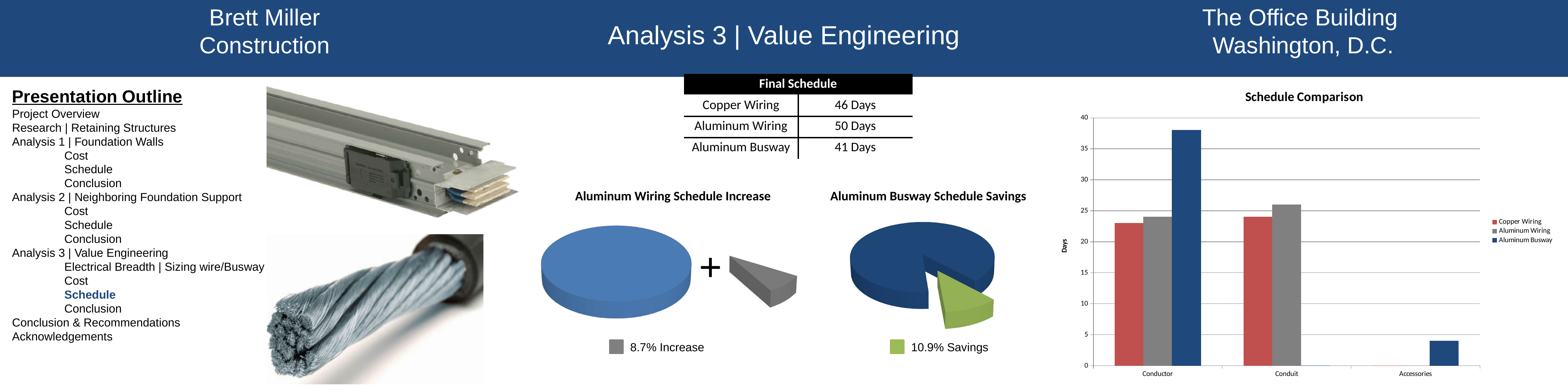
In the Aluminum Busway Schedule Savings pie chart, what share does the green slice represent? 10.9% Savings In the Schedule Comparison chart, how many categories are shown on the x axis? 3 In the Schedule Comparison chart, which category has the tallest Aluminum Busway bar? Conductor What kind of chart is the Schedule Comparison chart? bar chart In the Schedule Comparison chart, is the Aluminum Busway value for Conductor greater or less than 35? greater In the Aluminum Wiring Schedule Increase pie chart, what does the gray slice represent? 8.7% Increase In the Schedule Comparison chart, which is larger for Conduit: Copper Wiring or Aluminum Busway? Copper Wiring In the Schedule Comparison chart, is the Copper Wiring value for Conductor greater or less than 25? less In the Schedule Comparison chart, what is the label on the vertical axis? Days In the Schedule Comparison chart, is the Aluminum Busway value for Accessories greater or less than 5? less In the Schedule Comparison chart, which series has the highest bar for Conductor? Aluminum Busway In the Schedule Comparison chart, how many series does the legend list? 3